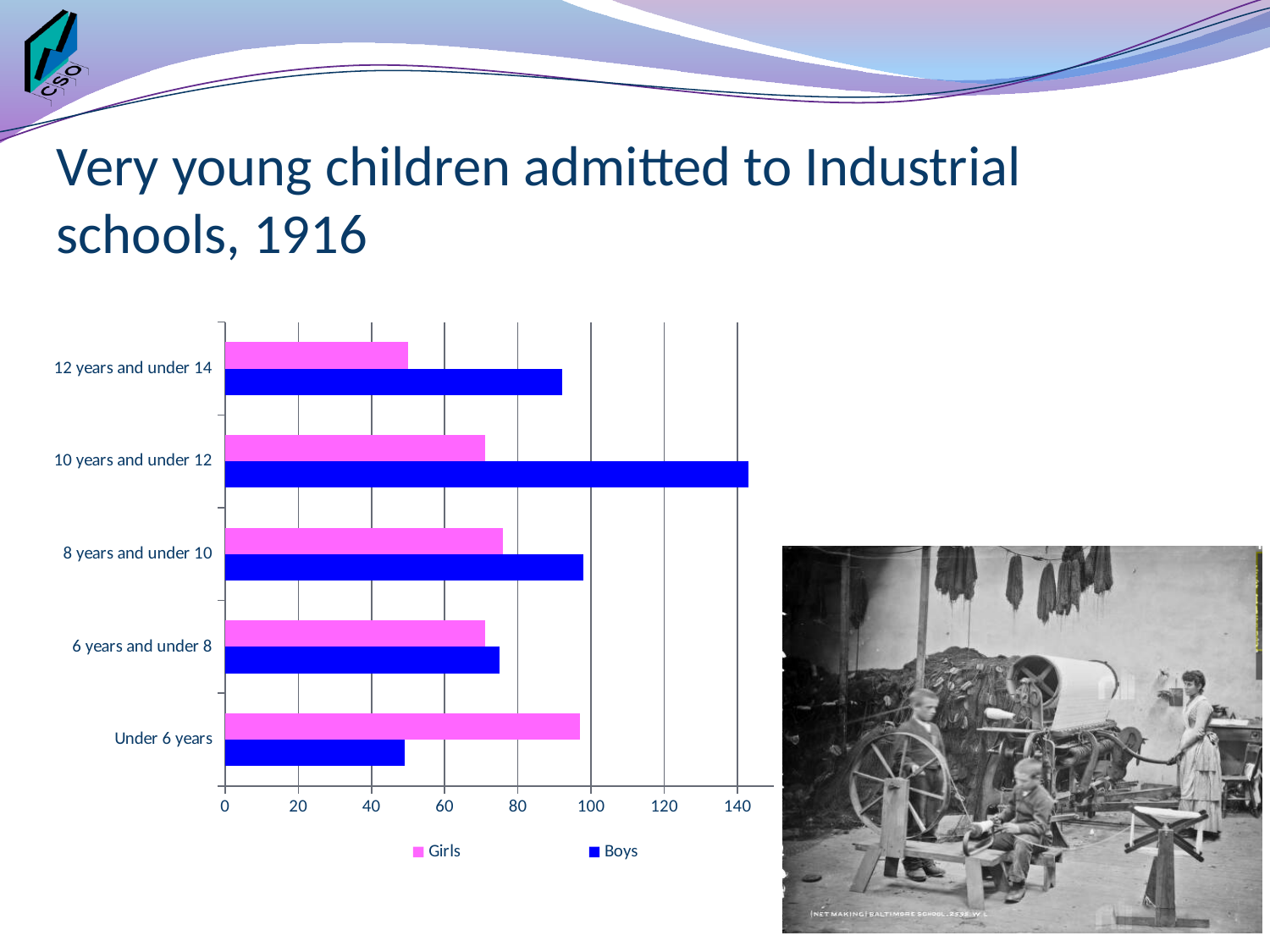
Which age category has the lowest value for Boys? Under 6 years Which age category has the highest value for Boys? 10 years and under 12 How many series does the legend list? 2 Is the value for Boys in the 10 years and under 12 category greater or less than 120? greater Which age category has the lowest value for Girls? 12 years and under 14 For the Under 6 years category, which is larger, Girls or Boys? Girls Is the value for Girls in the 12 years and under 14 category greater or less than 60? less What kind of chart is shown on the slide? bar chart For the 10 years and under 12 category, which is larger, Girls or Boys? Boys What colour are the bars for the Girls series? pink How many age categories are shown on the chart? 5 Which age category has the highest value for Girls? Under 6 years